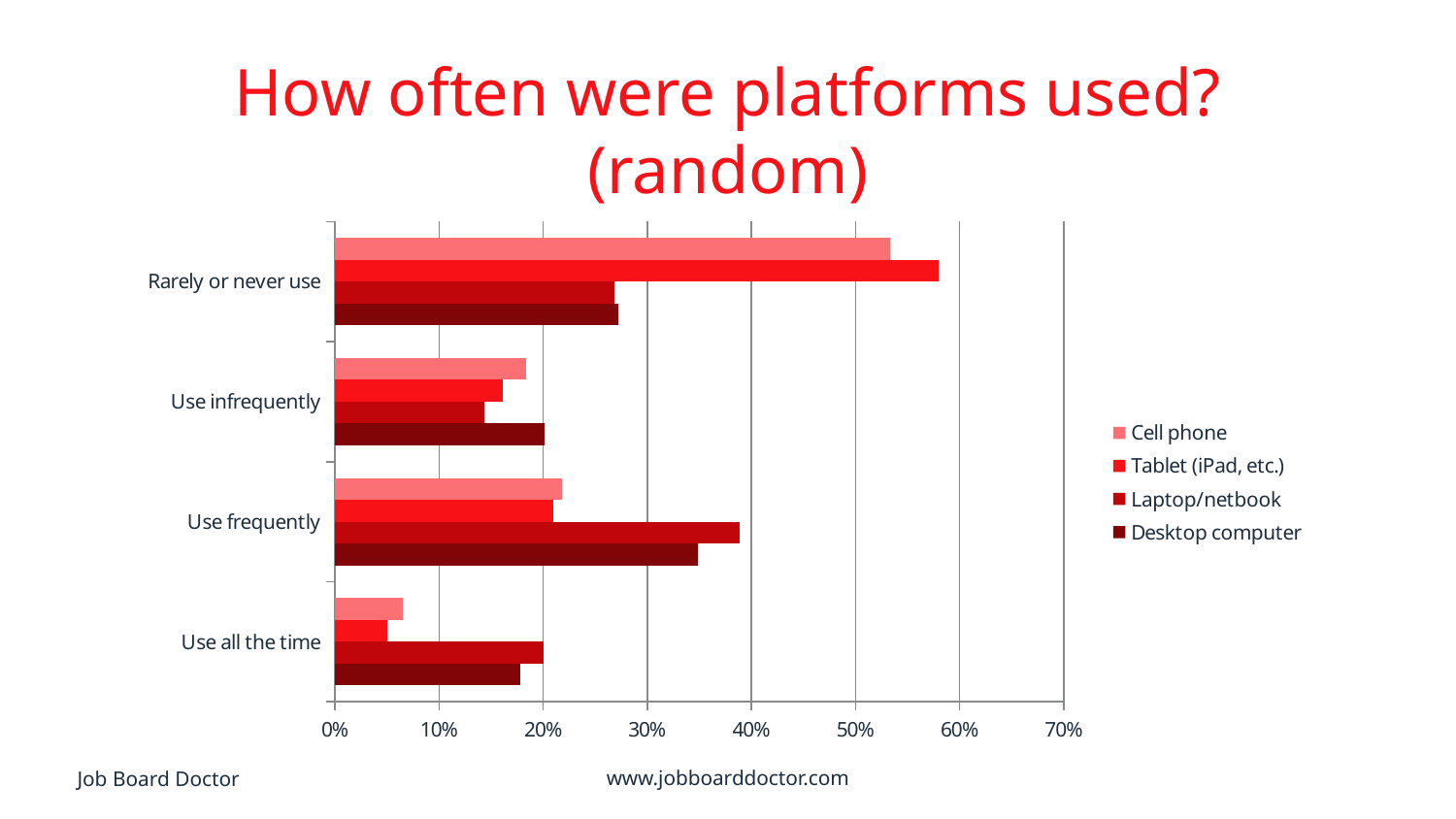
Is the value for Laptop/netbook in the "Use frequently" category greater or less than 30%? greater Is the value for Cell phone in the "Use all the time" category greater or less than 10%? less Which platform has the highest value in the "Rarely or never use" category? Tablet (iPad, etc.) Which platform has the highest value in the "Use frequently" category? Laptop/netbook Is the value for Desktop computer in the "Rarely or never use" category greater or less than 30%? less What kind of chart is shown on the slide? Bar chart What is the title of the chart on the slide? How often were platforms used? (random) How many usage-frequency categories are shown on the vertical axis? 4 In the "Use all the time" category, which is larger: the value for Cell phone or for Laptop/netbook? Laptop/netbook How many series does the legend list? 4 In the "Rarely or never use" category, which is larger: the value for Cell phone or for Laptop/netbook? Cell phone